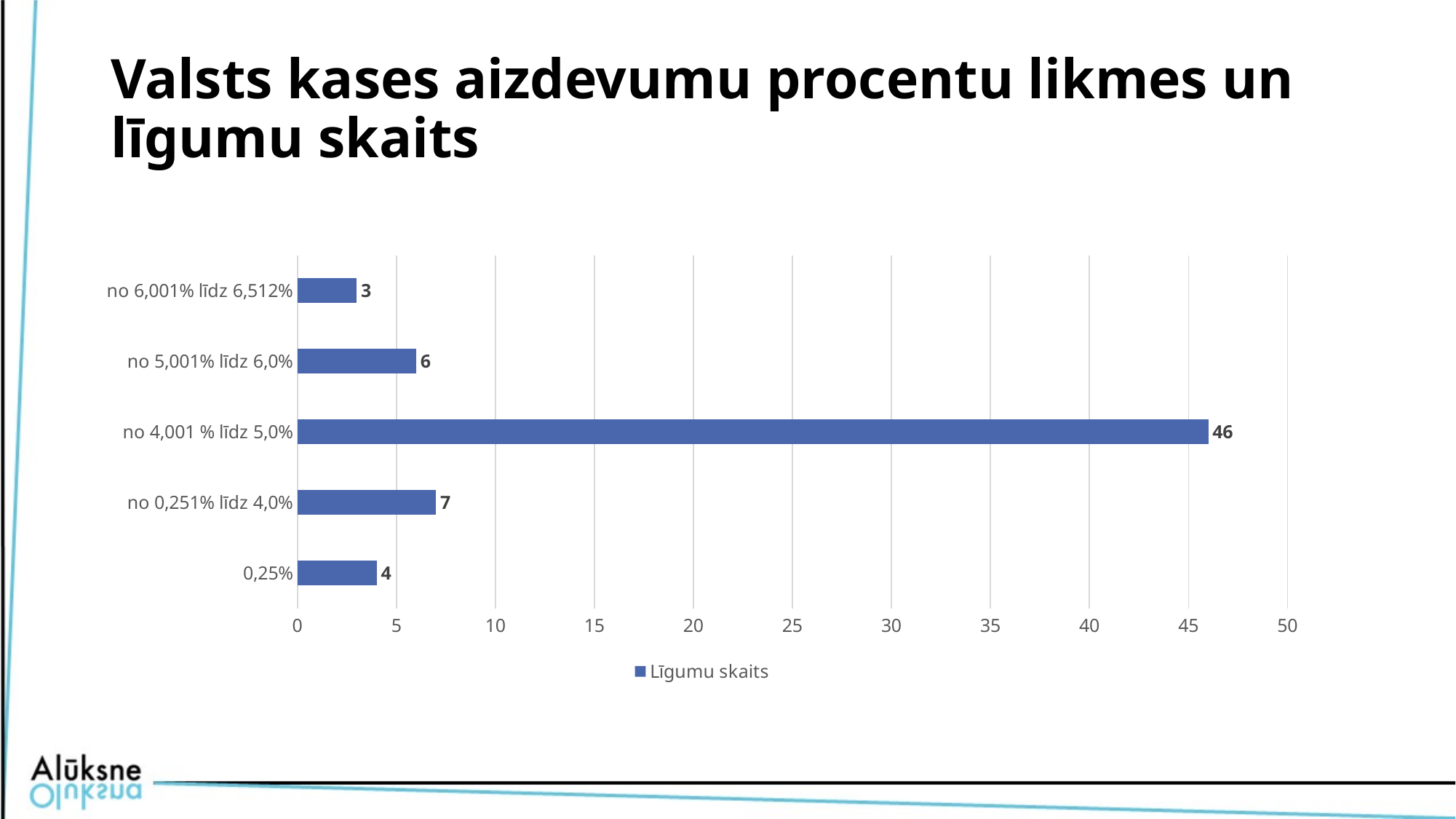
What is the value for the category "no 6,001% līdz 6,512%"? 3 Which is larger, the value for "no 5,001% līdz 6,0%" or the value for "0,25%"? no 5,001% līdz 6,0% What is the value for the category "no 4,001 % līdz 5,0%"? 46 What is the value for the category "0,25%"? 4 What is the name of the series shown in the legend? Līgumu skaits Is the value for "no 4,001 % līdz 5,0%" greater or less than 40? greater How many series does the legend list? 1 Which category has the lowest value? no 6,001% līdz 6,512% How many categories are shown in the chart? 5 What is the difference between the values for "no 4,001 % līdz 5,0%" and "no 0,251% līdz 4,0%"? 39 What kind of chart is shown on the slide? bar chart Which category has the highest value? no 4,001 % līdz 5,0%